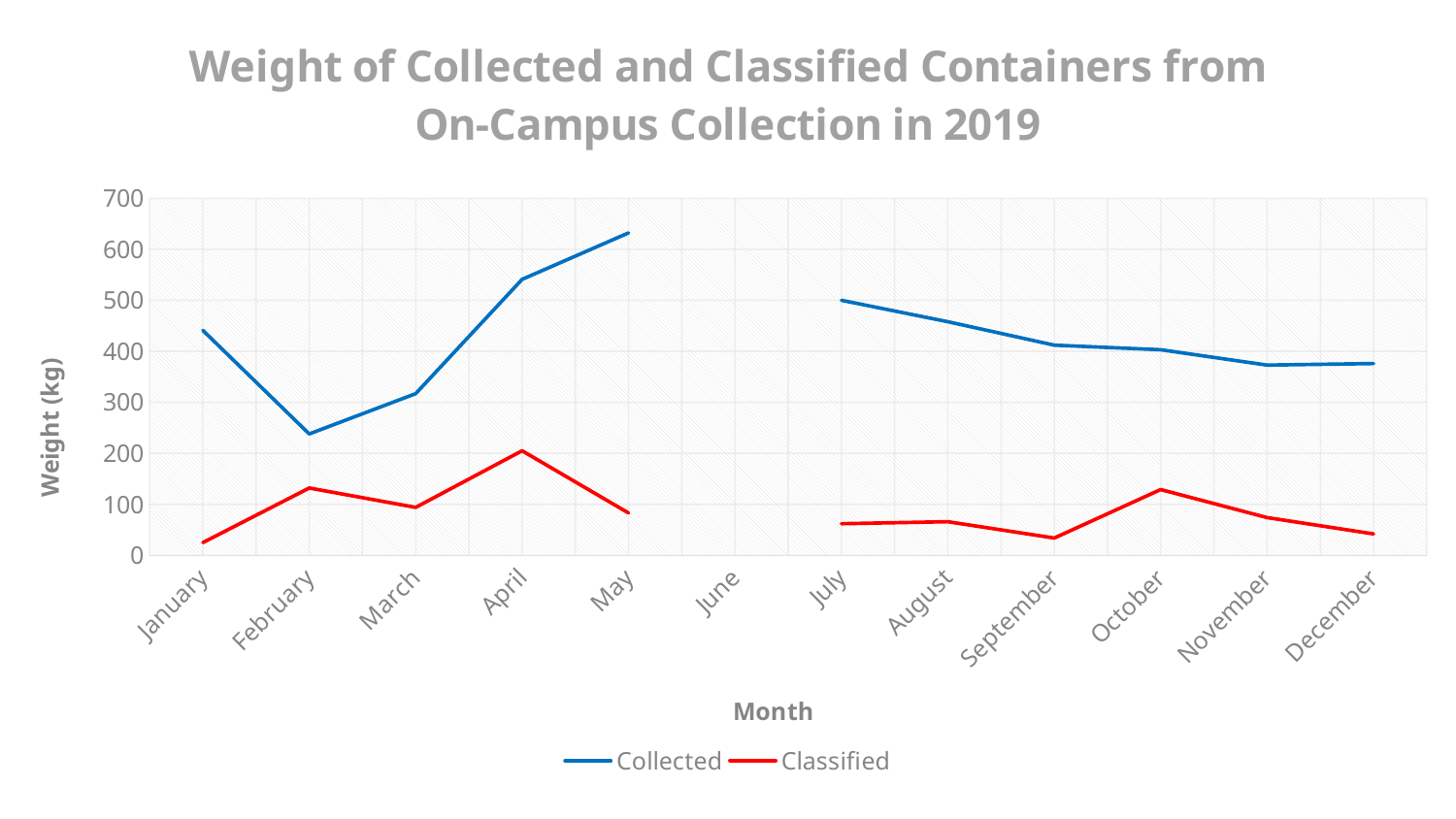
Is the Collected value for February greater or less than 300? less Which month has the highest Collected weight? May Is the Collected value for May greater or less than 600? greater How many series does the legend list? 2 Which is larger, the Collected value for January or the Collected value for March? January Does the Collected line rise or fall from July to November? Fall Which month has the lowest Collected weight? February How many months are shown on the x axis? 12 What kind of chart is shown on the slide? Line chart Which month has the highest Classified weight? April Which month has no data plotted for either series? June